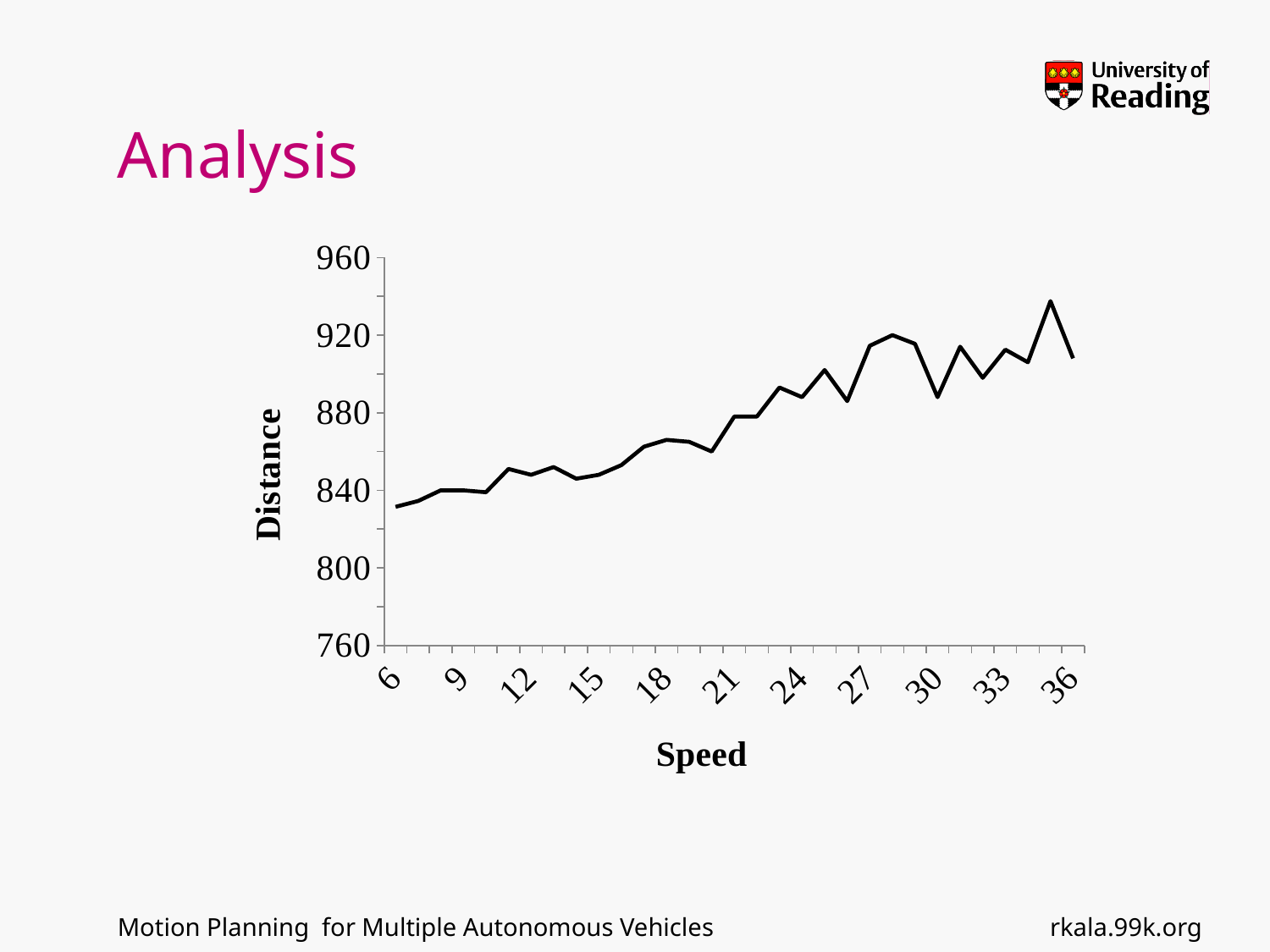
Is the Distance value at Speed 24 greater or less than 880? greater What is the label of the x axis of the chart? Speed How many tick labels are shown on the Speed axis? 11 Is the Distance value at Speed 6 greater or less than 840? less What kind of chart is shown on the slide? line chart Is the Distance value at Speed 18 greater or less than 880? less Which Speed value has the lowest Distance on the chart? 6 What is the label of the y axis of the chart? Distance Overall, does Distance rise or fall as Speed increases from 6 to 36? rise